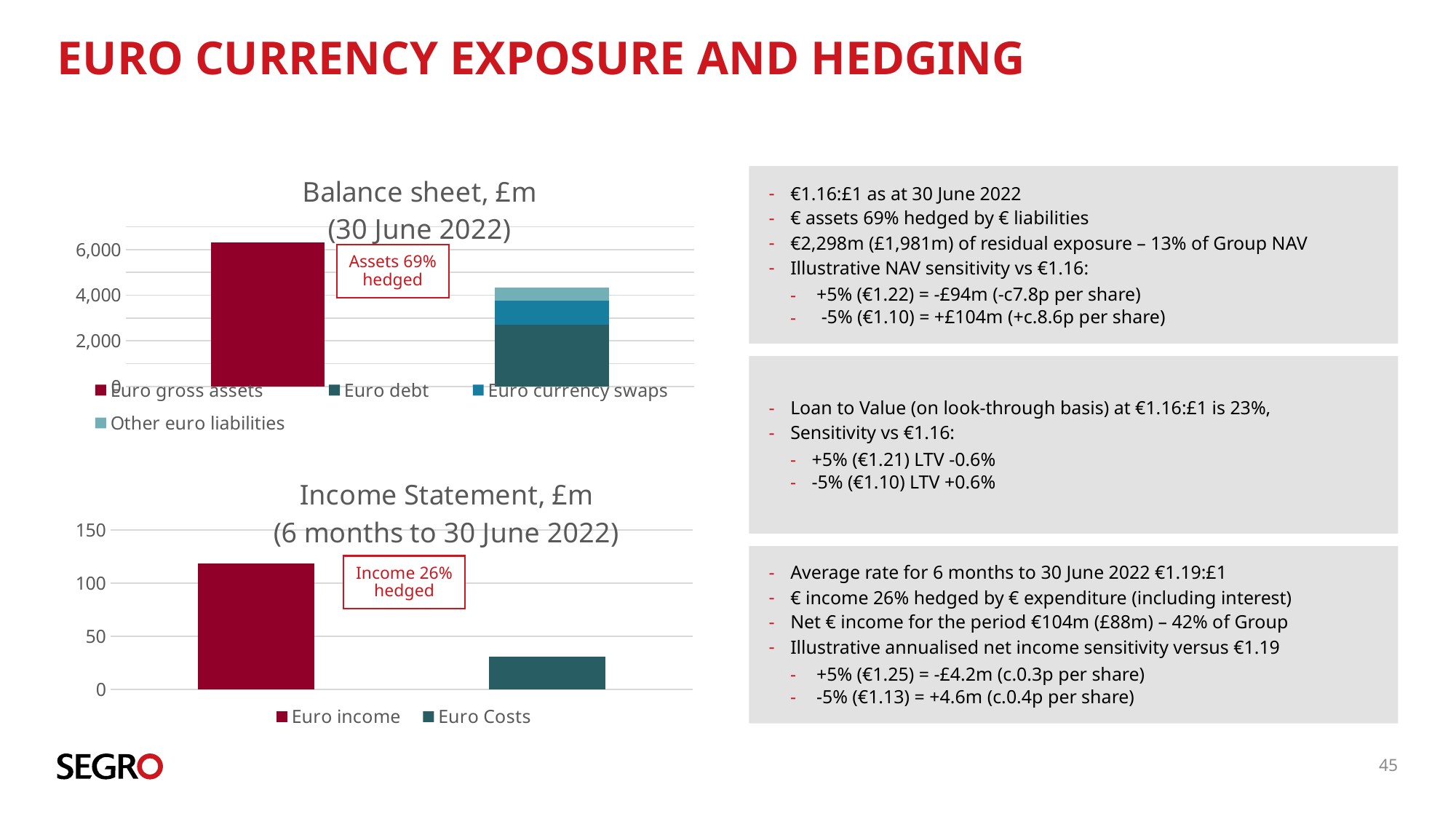
What does the red annotation box on the 'Balance sheet, £m (30 June 2022)' chart say? Assets 69% hedged How many series does the legend of the 'Income Statement, £m (6 months to 30 June 2022)' chart list? 2 In the 'Balance sheet, £m (30 June 2022)' chart, is the total of the stacked liabilities bar greater or less than 6,000? less In the 'Income Statement, £m (6 months to 30 June 2022)' chart, is the value for Euro income greater or less than 100? greater In the 'Balance sheet, £m (30 June 2022)' chart, which is larger: the Euro gross assets bar or the stacked liabilities bar? Euro gross assets What kind of chart is the 'Income Statement, £m (6 months to 30 June 2022)' chart? bar chart What kind of chart is the 'Balance sheet, £m (30 June 2022)' chart? bar chart In the 'Income Statement, £m (6 months to 30 June 2022)' chart, is the value for Euro Costs greater or less than 50? less In the 'Income Statement, £m (6 months to 30 June 2022)' chart, which series has the higher value, Euro income or Euro Costs? Euro income How many series does the legend of the 'Balance sheet, £m (30 June 2022)' chart list? 4